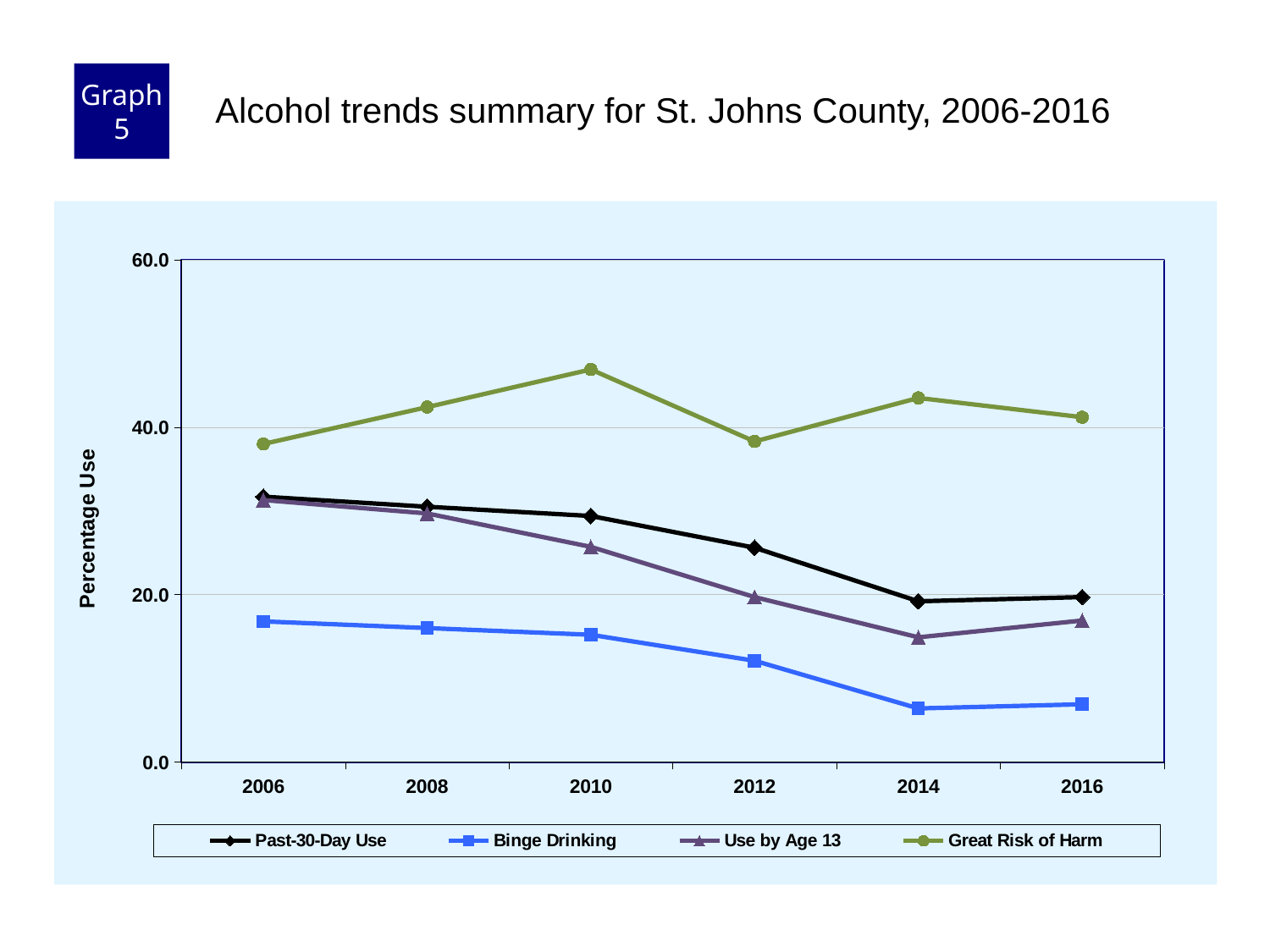
What kind of chart is shown on the slide? line chart What is the label on the y axis? Percentage Use In which year does the Great Risk of Harm series reach its highest value? 2010 Is the value for Past-30-Day Use in 2006 greater or less than 20? greater In 2012, which is larger: Past-30-Day Use or Use by Age 13? Past-30-Day Use Which series has the highest value in 2016? Great Risk of Harm Which series has the lowest value in 2016? Binge Drinking Is the value for Binge Drinking in 2014 greater or less than 20? less Is the value for Great Risk of Harm in 2010 greater or less than 40? greater Does the Binge Drinking series generally rise or fall from 2006 to 2016? fall How many series does the legend list? 4 How many years are plotted along the x axis? 6